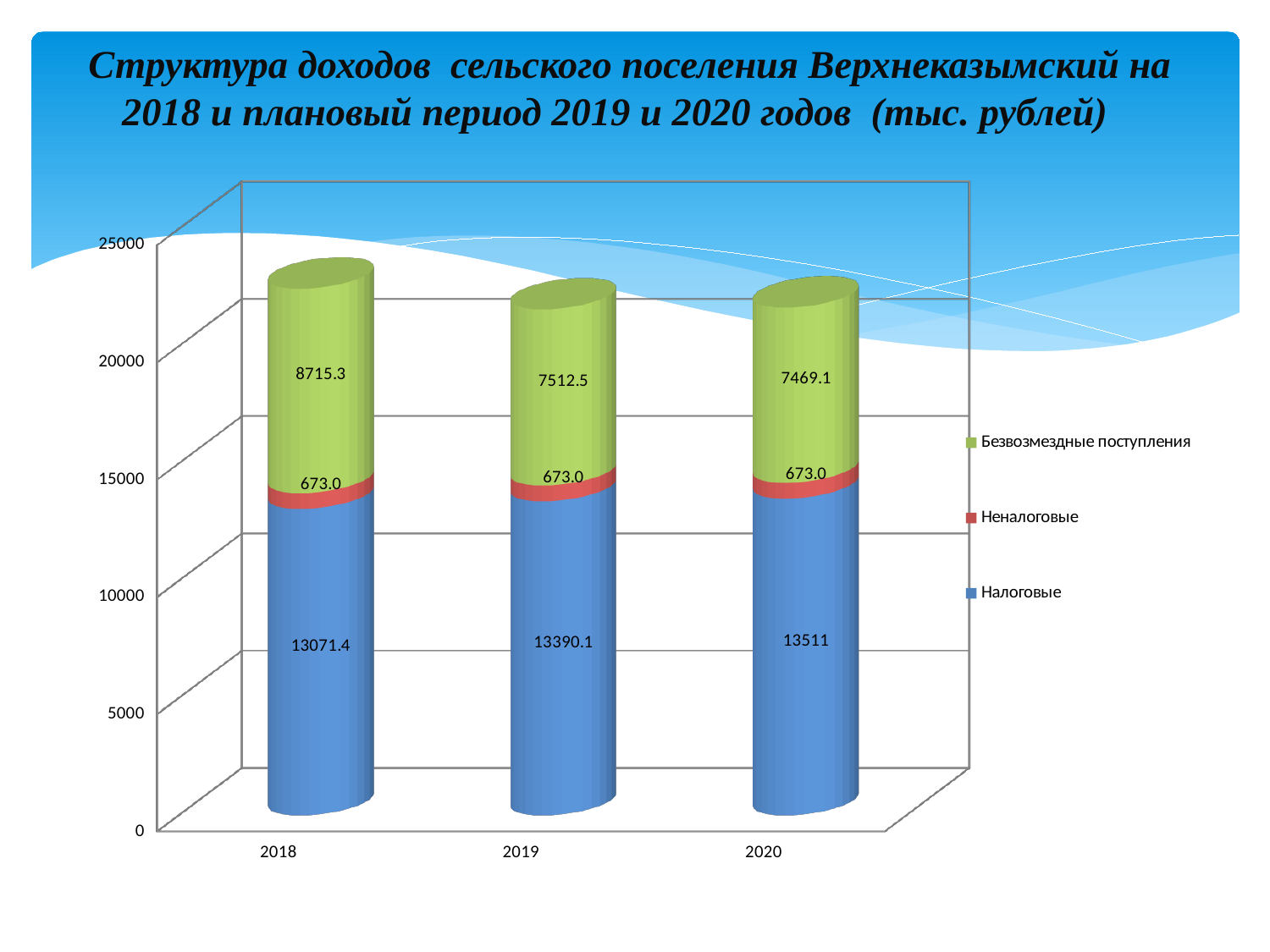
What is the value of Неналоговые for 2019? 673.0 Which is larger: Безвозмездные поступления in 2019 or in 2020? 2019 Do the Налоговые values rise or fall from 2018 to 2020? Rise How many years are shown on the x axis? 3 In which year is the Налоговые value lowest? 2018 How many series does the legend list? 3 What is the value of Безвозмездные поступления for 2020? 7469.1 What kind of chart is shown on the slide? Stacked bar chart What is the total of the stacked bar for 2018? 22459.7 What is the value of Налоговые for 2018? 13071.4 What is the difference between the Налоговые values for 2020 and 2019? 120.9 In which year is the Безвозмездные поступления value highest? 2018